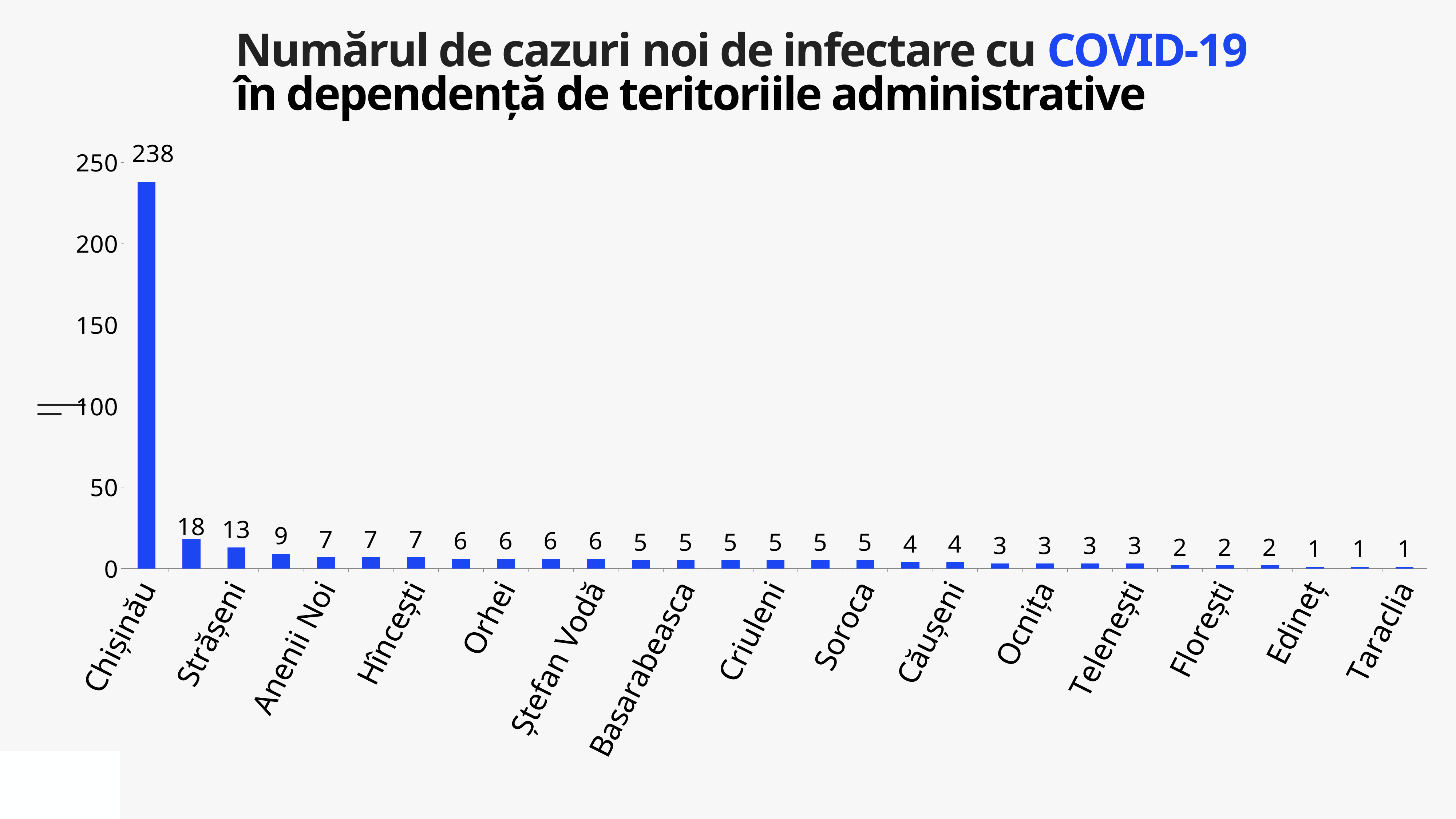
What kind of chart is shown on the slide? bar chart How many new cases are shown for Taraclia, the last territory on the x axis? 1 Do the values rise or fall from left to right along the x axis? fall How many bars are plotted in the chart? 29 Is the value for Chișinău greater or less than 200? greater What is the difference between the highest value (238) and the second-highest value (18)? 220 What is the smallest value shown on any bar in the chart? 1 Which territory has the highest number of new COVID-19 cases? Chișinău What colour are the bars in the chart? blue What is the title of the chart? Numărul de cazuri noi de infectare cu COVID-19 în dependență de teritoriile administrative What is the second-highest value shown in the chart? 18 How many new COVID-19 cases are shown for Chișinău? 238